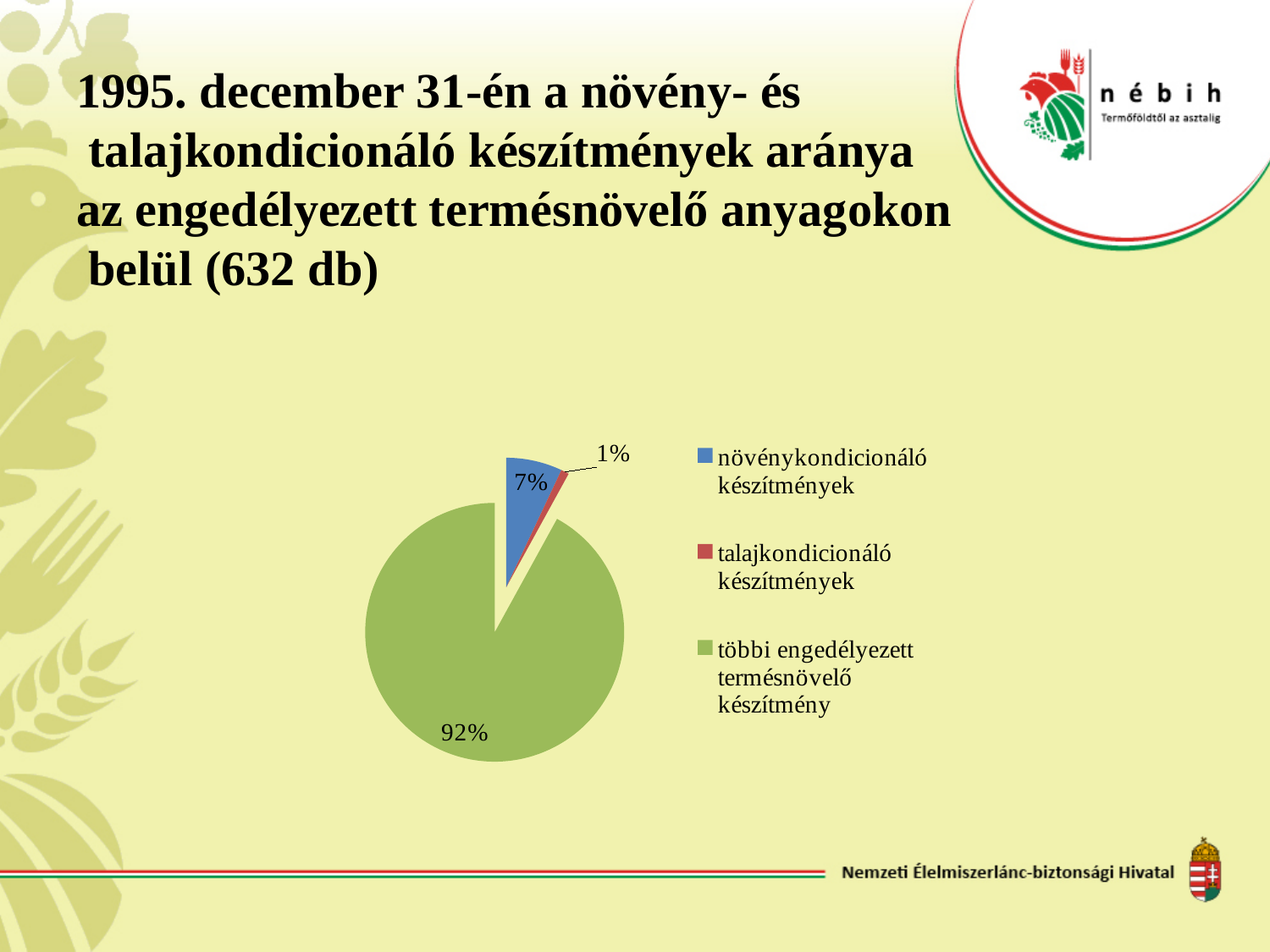
How many entries does the legend list? 3 What share of the pie does 'talajkondicionáló készítmények' have? 1% How many categories does the pie chart have? 3 What colour is the slice for 'többi engedélyezett termésnövelő készítmény'? green Which category has the largest slice of the pie? többi engedélyezett termésnövelő készítmény Which is larger: the 'növénykondicionáló készítmények' slice or the 'talajkondicionáló készítmények' slice? növénykondicionáló készítmények What share of the pie does 'többi engedélyezett termésnövelő készítmény' have? 92% What colour is the slice for 'növénykondicionáló készítmények'? blue What kind of chart is shown on the slide? pie chart What is the difference in percentage points between the 'többi engedélyezett termésnövelő készítmény' slice and the 'növénykondicionáló készítmények' slice? 85 percentage points What share of the pie does 'növénykondicionáló készítmények' have? 7% Which category has the smallest slice of the pie? talajkondicionáló készítmények